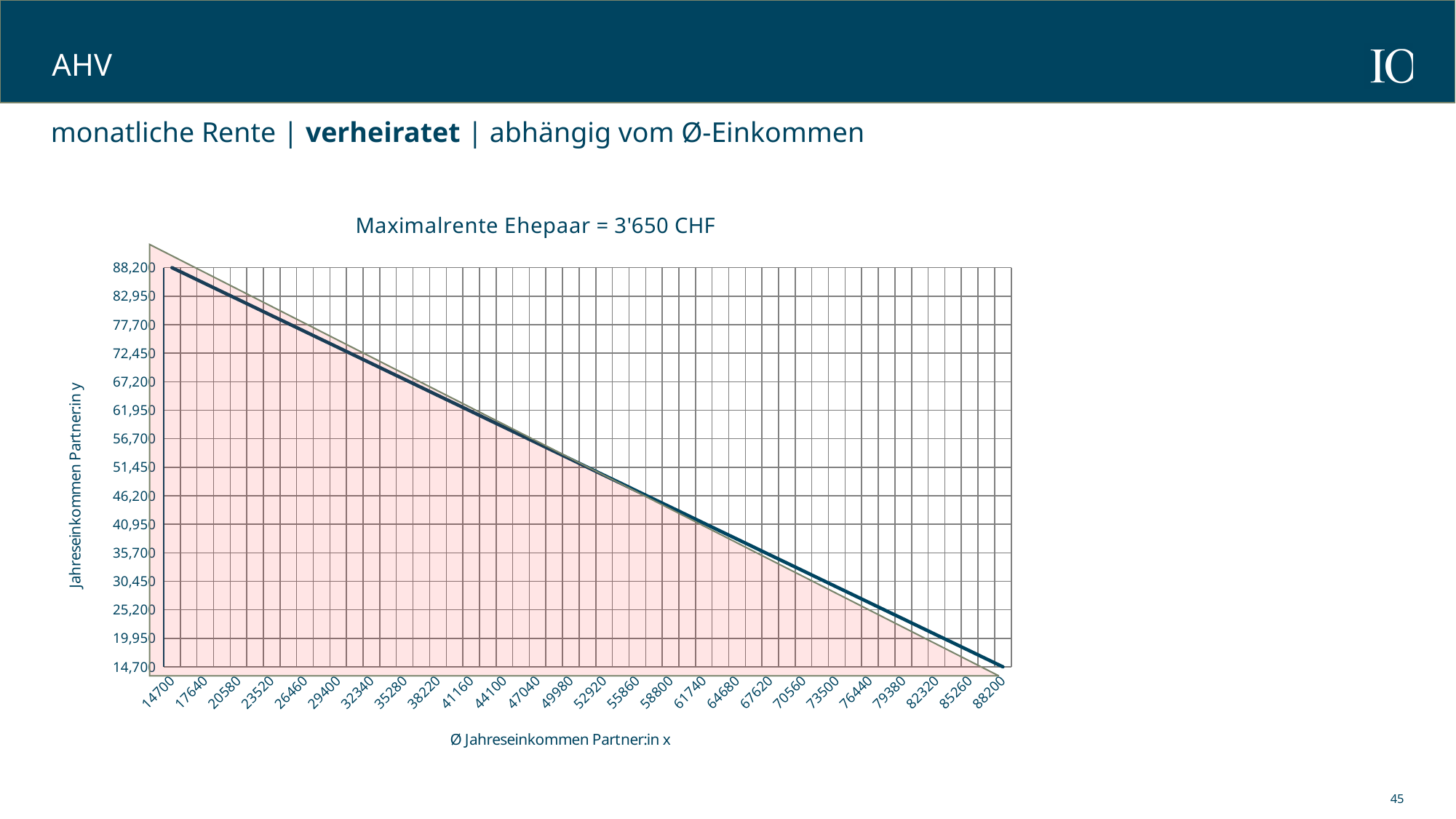
Do the values of the line rise or fall as the x axis increases? fall How many tick labels are shown on the x axis? 26 At which x value does the line reach its highest y value? 14700 What is the y value of the line at x = 88200? 14,700 What is the label of the x axis? Ø Jahreseinkommen Partner:in x Which has the larger y value on the line: x = 23520 or x = 64680? 23520 What is the y value of the line at x = 14700? 88,200 Is the y value of the line at x = 29400 greater or less than 67,200? greater Is the y value of the line at x = 73500 greater or less than 35,700? less What is the title of the chart? Maximalrente Ehepaar = 3'650 CHF What kind of chart is shown on the slide? line chart At which x value does the line reach its lowest y value? 88200